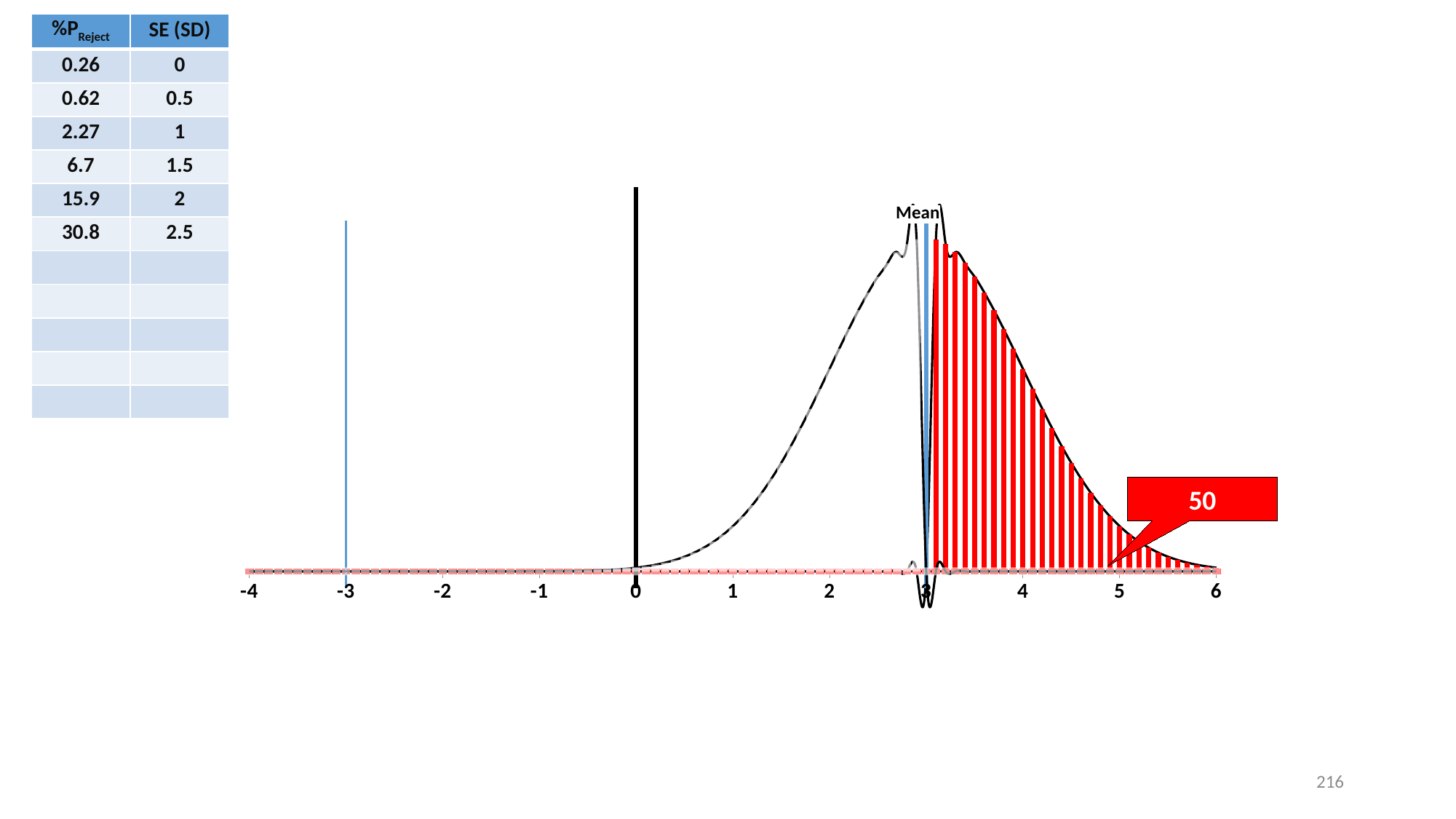
What value is shown in the red callout on the chart? 50 What kind of chart is shown on the slide? line chart How many tick labels are shown on the x axis? 11 Does the curve rise or fall along the x axis between 4 and 6? fall At which x-axis value is the thin blue vertical line on the left drawn? -3 Is the x-axis position of the Mean line greater or less than 2? greater What label is printed at the peak of the curve? Mean At which x-axis value is the thick black vertical line drawn? 0 On which side of the Mean line is the area under the curve shaded red? right Does the curve rise or fall along the x axis between 0 and 2? rise Is the x-axis position of the Mean line greater or less than 4? less